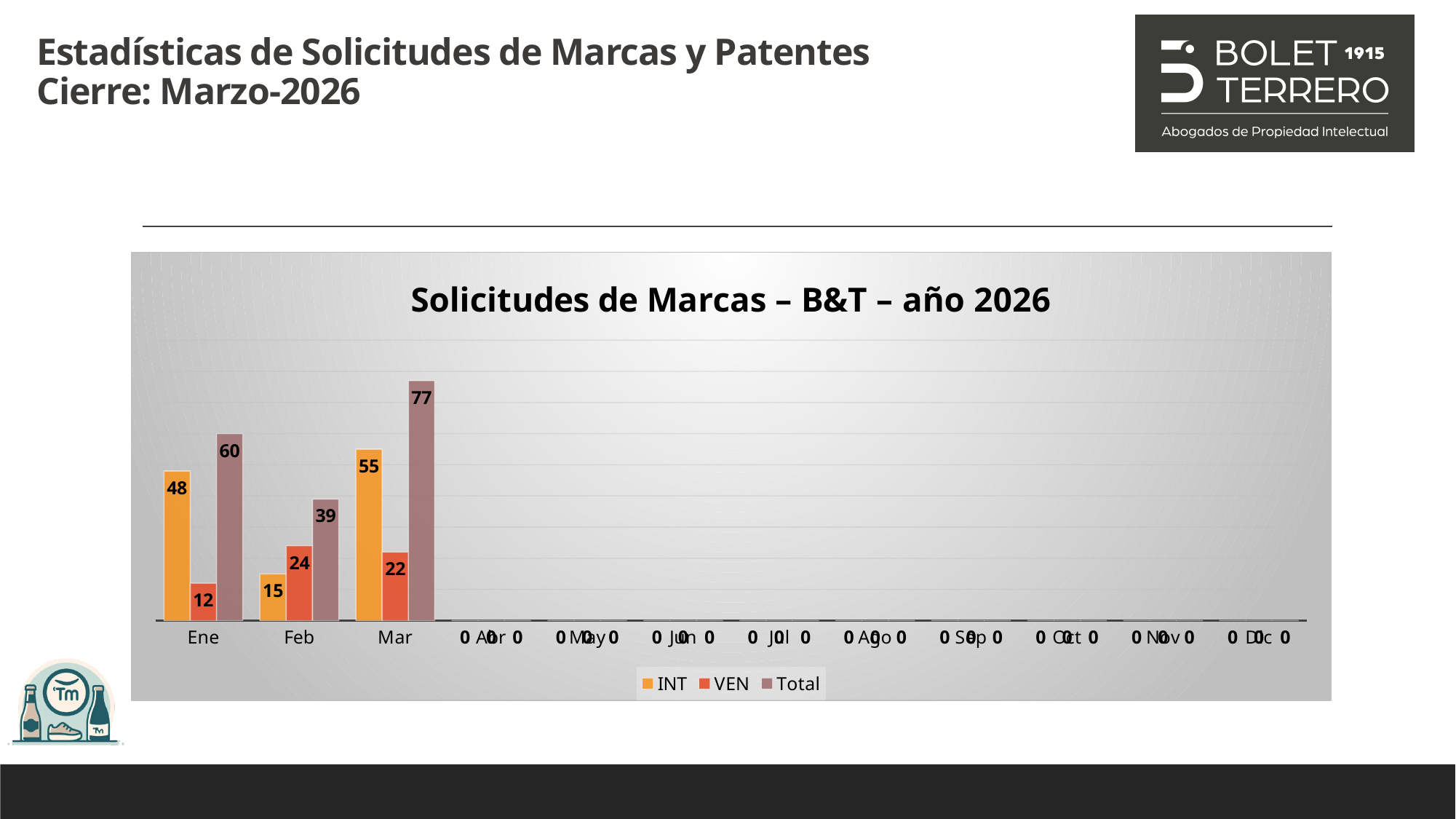
How many months are shown on the x axis? 12 How many series does the legend list? 3 What type of chart is shown on the slide? Bar chart Which is larger, the INT value for Feb or the VEN value for Feb? VEN value for Feb Among Ene, Feb and Mar, which month has the lowest INT value? Feb What is the title of the chart? Solicitudes de Marcas – B&T – año 2026 Which month has the highest Total value? Mar What is the INT value for Ene? 48 What is the Total value for Mar? 77 What is the difference between the Total values for Mar and Feb? 38 What is the VEN value for Mar? 22 What is the VEN value for Feb? 24